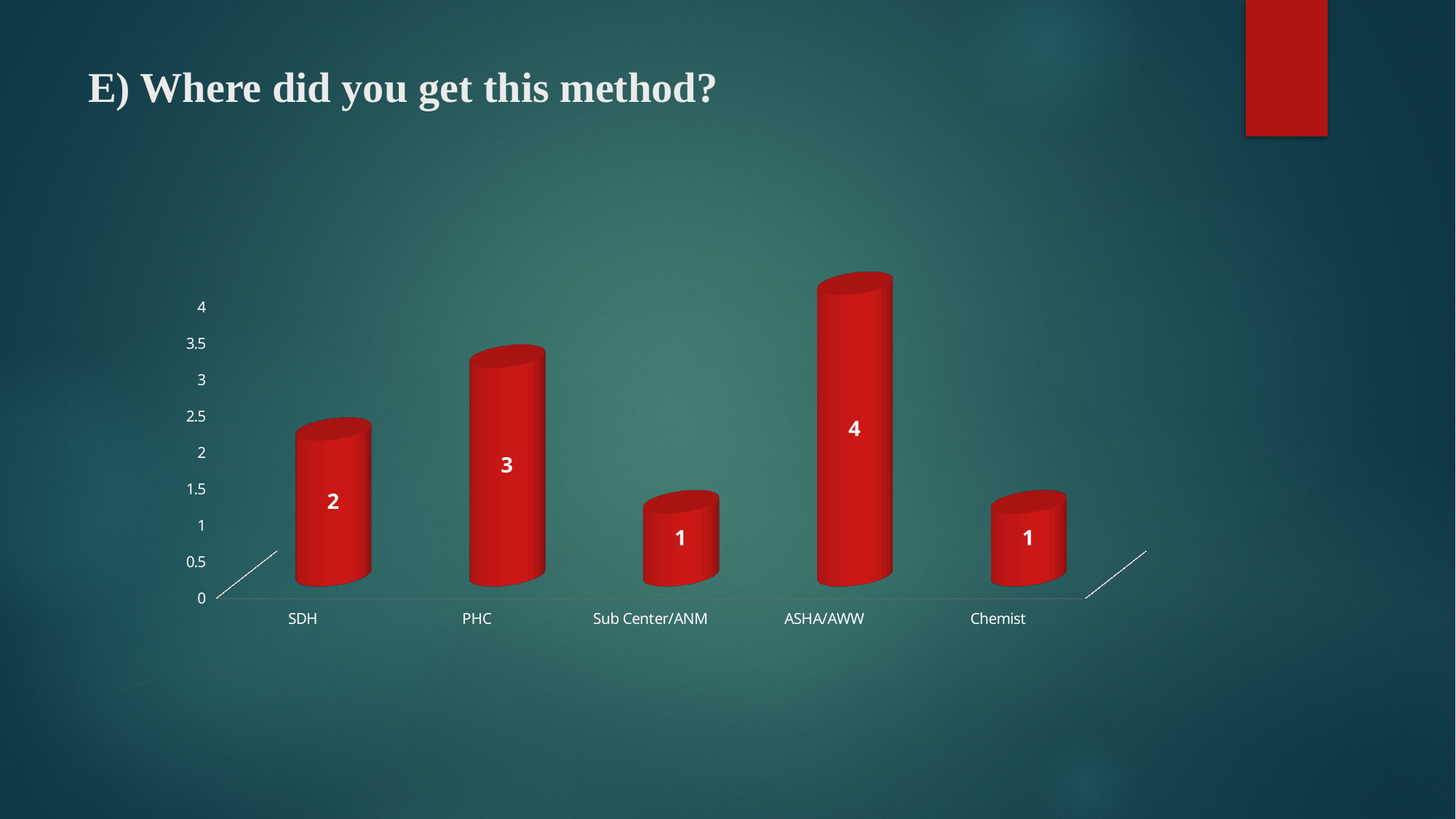
What is the difference between the values for PHC and Chemist? 2 What kind of chart is shown on the slide? bar chart What is the value for SDH? 2 Which is larger, the value for PHC or the value for SDH? PHC What is the value for Chemist? 1 What is the value for ASHA/AWW? 4 What is the value for Sub Center/ANM? 1 What is the difference between the values for ASHA/AWW and SDH? 2 What is the title of the slide containing the chart? E) Where did you get this method? How many categories are shown on the x axis? 5 What is the value for PHC? 3 Which category has the highest value? ASHA/AWW